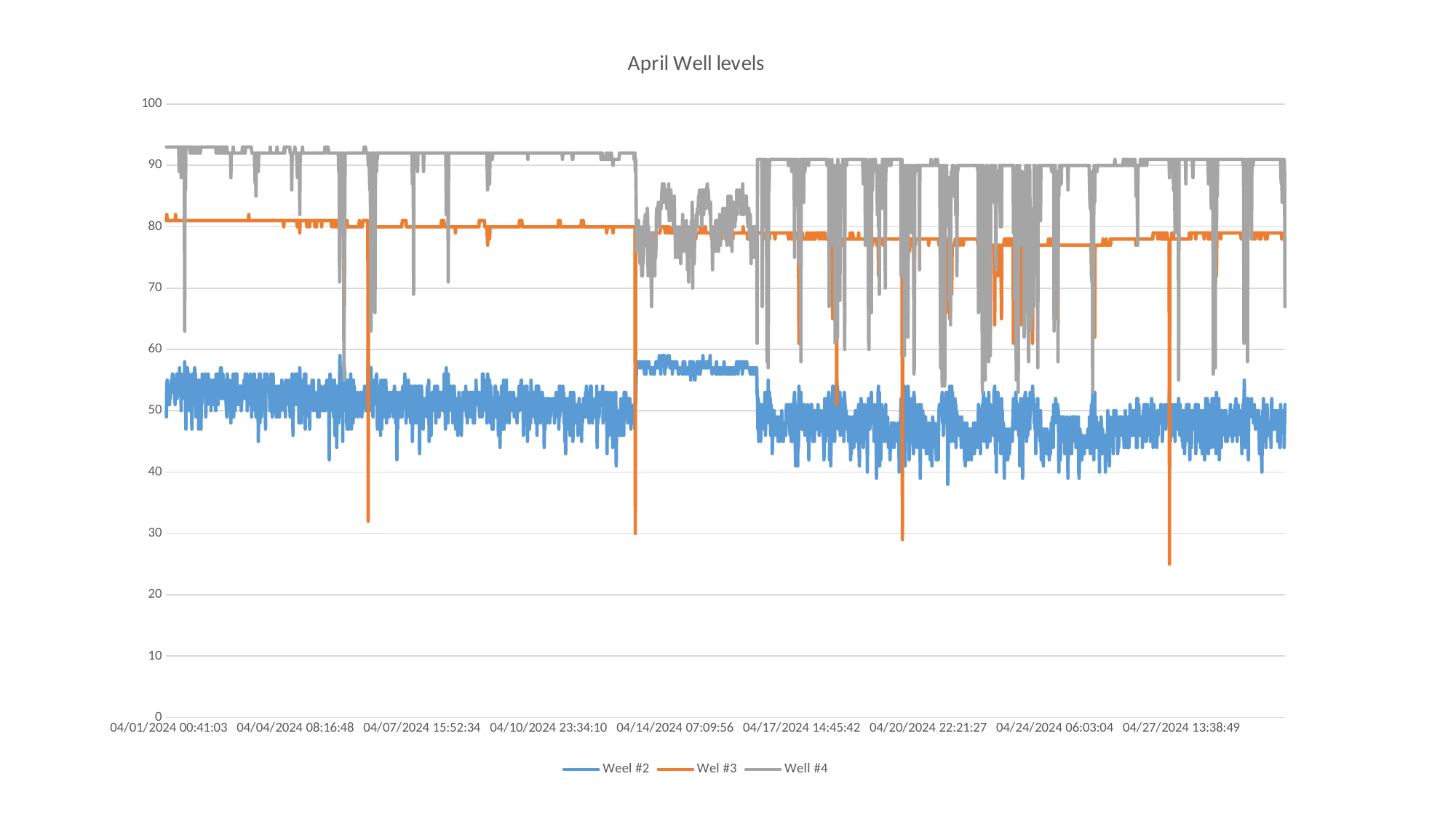
What is the highest value shown on the vertical axis? 100 What kind of chart is shown on the slide? Line chart How many series does the legend list? 3 Which series is drawn in orange? Wel #3 Around 04/14/2024, which series is higher, Weel #2 or Wel #3? Wel #3 Is the lowest dip of Wel #3 greater or less than 30? less Does the typical level of Weel #2 rise or fall from the start of April to the end of April? Fall Which series generally has the highest values across the chart? Well #4 Is the value for Well #4 at the start of the chart greater or less than 90? greater What is the title of the chart? April Well levels Is the value for Weel #2 at the start of the chart greater or less than 60? less Which series generally has the lowest values across the chart? Weel #2